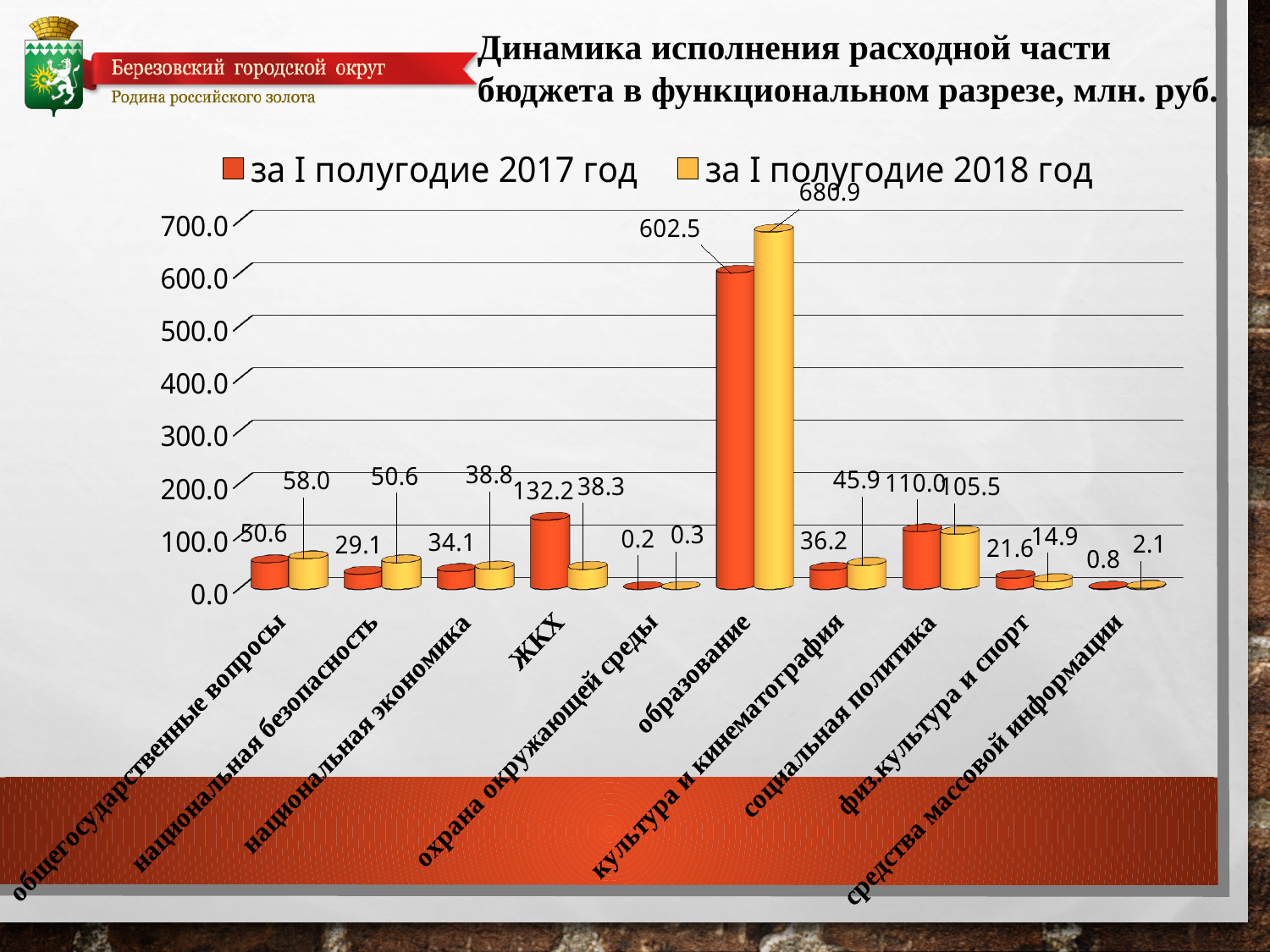
For ЖКХ, which series has the larger value: за I полугодие 2017 год or за I полугодие 2018 год? за I полугодие 2017 год What is the difference between the за I полугодие 2018 год and за I полугодие 2017 год values for национальная безопасность? 21.5 What is the value for ЖКХ for за I полугодие 2017 год? 132.2 How many series does the legend list? 2 Which category has the highest value for за I полугодие 2017 год? образование What type of chart is shown on the slide? bar chart Is the value for образование for за I полугодие 2017 год greater or less than 500.0? greater What is the value for образование for за I полугодие 2018 год? 680.9 How many categories are shown on the x axis? 10 What is the difference between the за I полугодие 2018 год and за I полугодие 2017 год values for образование? 78.4 What is the value for социальная политика for за I полугодие 2018 год? 105.5 Which category has the lowest value for за I полугодие 2018 год? охрана окружающей среды